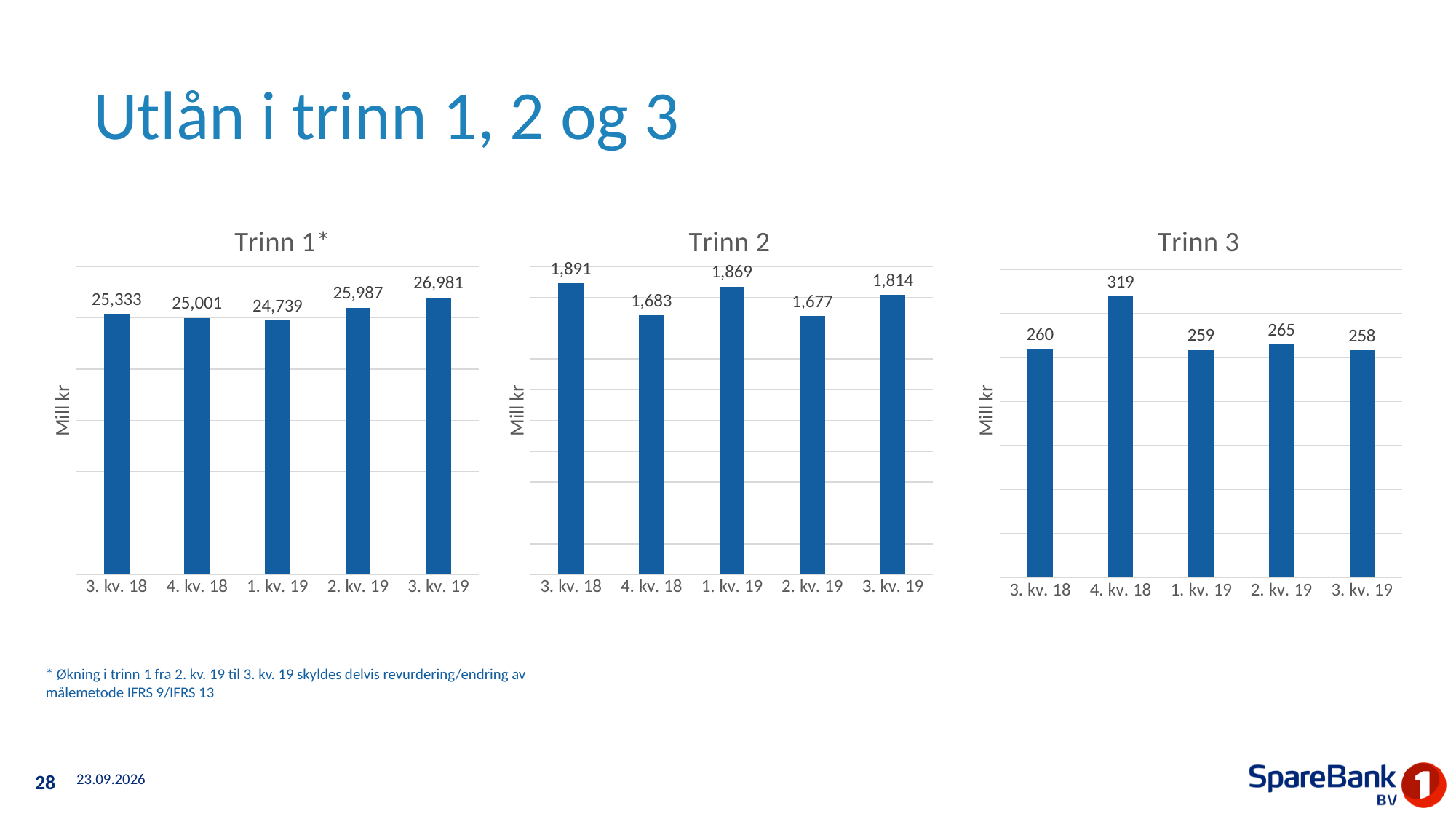
In the Trinn 2 chart, what is the value for 4. kv. 18? 1,683 In the Trinn 3 chart, which quarter has the lowest value? 3. kv. 19 In the Trinn 2 chart, which is larger, 1. kv. 19 or 2. kv. 19? 1. kv. 19 What is the y-axis label on the Trinn 1* chart? Mill kr In the Trinn 1* chart, what is the difference between 3. kv. 19 and 2. kv. 19? 994 In the Trinn 2 chart, which quarter has the highest value? 3. kv. 18 In the Trinn 3 chart, what is the value for 4. kv. 18? 319 In the Trinn 3 chart, what is the difference between 4. kv. 18 and 3. kv. 18? 59 In the Trinn 1* chart, what is the value for 3. kv. 19? 26,981 How many quarters are shown in the Trinn 2 chart? 5 What kind of chart is the Trinn 3 chart? Bar chart In the Trinn 1* chart, which quarter has the lowest value? 1. kv. 19